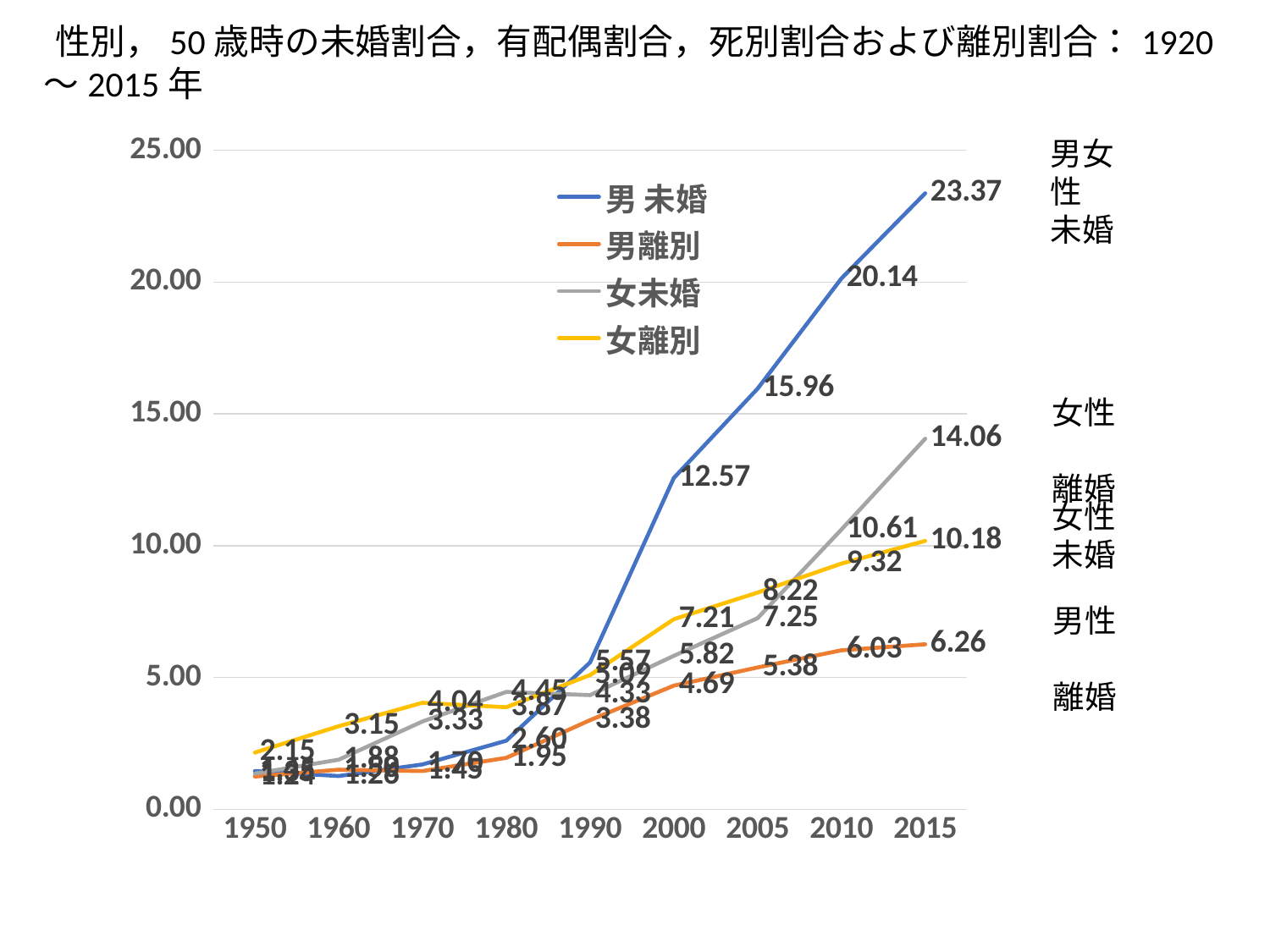
What is the value of 女未婚 in 2010? 10.61 By how much did 男 未婚 increase from 2010 to 2015? 3.23 What is the value of 男 未婚 in 2015? 23.37 Which series has the highest value in 2015? 男 未婚 What kind of chart is shown on the slide? Line chart How many series does the legend list? 4 How many years are shown on the x axis? 9 What is the value of 男離別 in 2000? 4.69 Which series has the lowest value in 2015? 男離別 In 2000, which is larger: 女離別 or 女未婚? 女離別 What is the difference between 女未婚 and 女離別 in 2015? 3.88 What is the value of 女離別 in 2005? 8.22